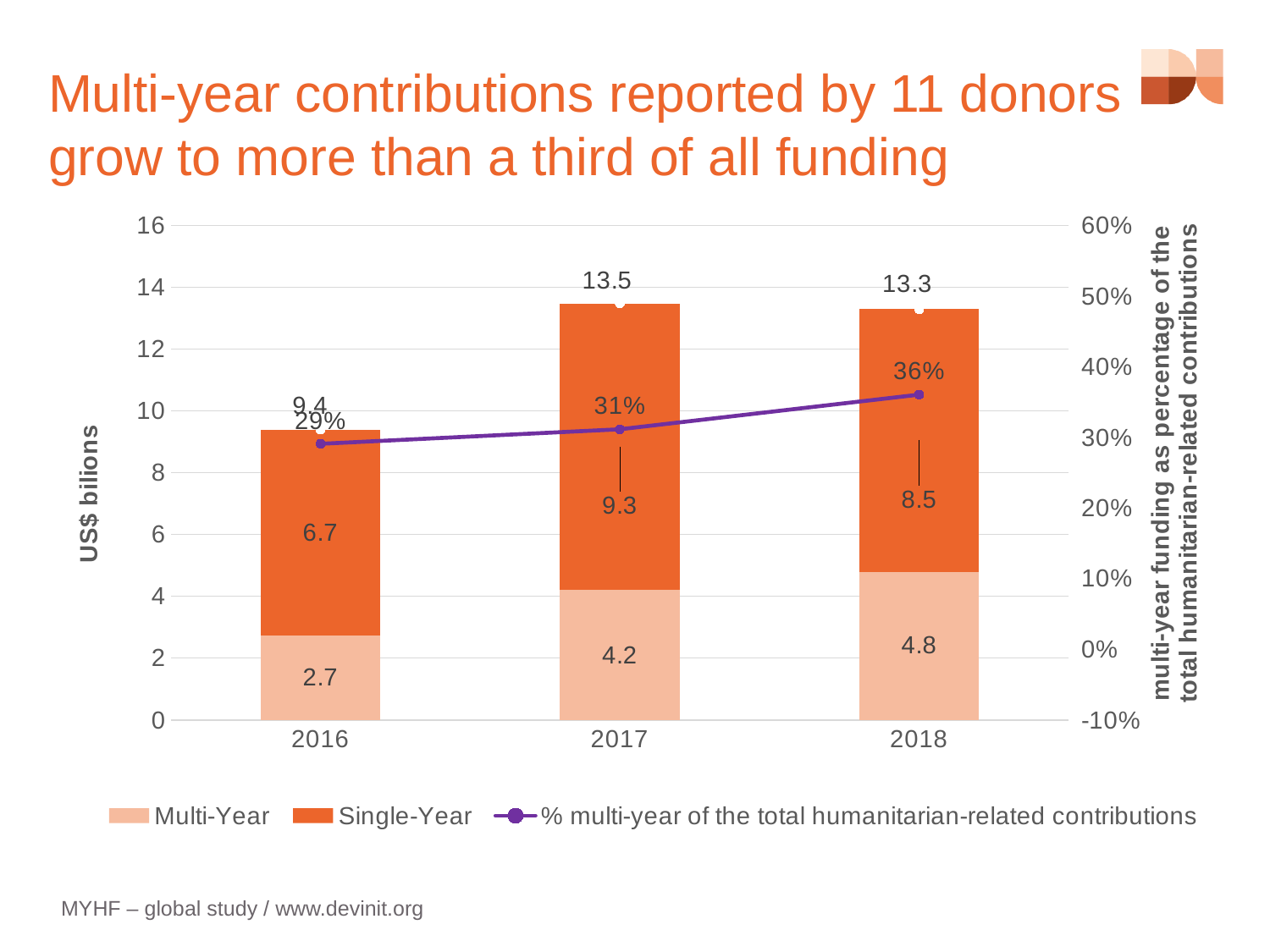
What is the Single-Year value for 2017? 9.3 What is the Multi-Year value for 2018? 4.8 How many years are shown on the x axis? 3 What percentage of total humanitarian-related contributions was multi-year in 2017? 31% What is the total of the stacked bar for 2017? 13.5 What is the difference between the Single-Year values for 2017 and 2018? 0.8 How many series does the legend list? 3 Which year has the highest Multi-Year value? 2018 Does the % multi-year of the total humanitarian-related contributions rise or fall from 2016 to 2018? Rise Is the Single-Year value for 2016 larger than the Single-Year value for 2018? No What is the Multi-Year value for 2016? 2.7 Which year has the lowest Single-Year value? 2016